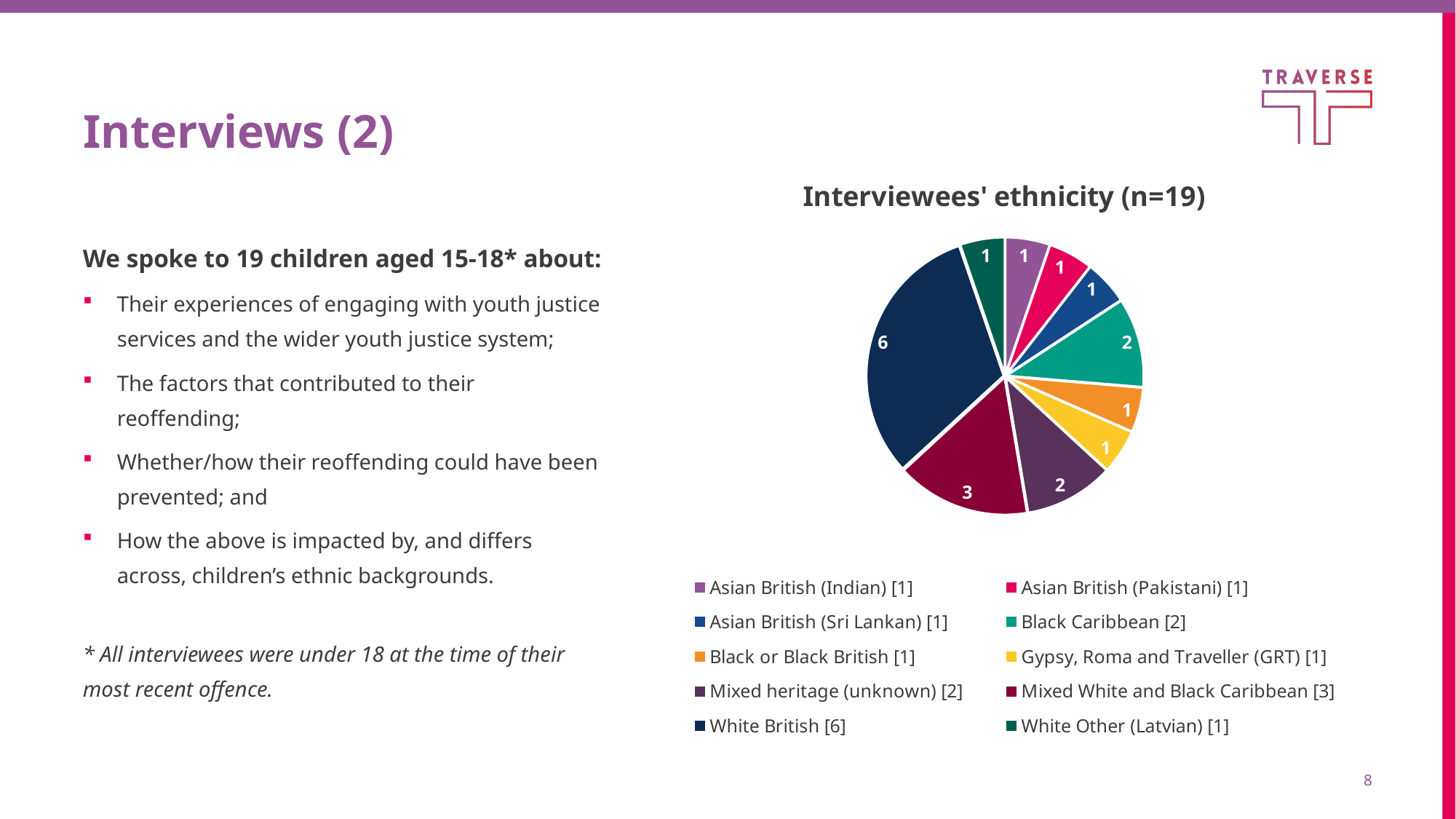
Which ethnicity category has the largest slice of the pie? White British How many categories in the chart have a value of 1? 6 Which is larger: the number of Black Caribbean interviewees or the number of Black or Black British interviewees? Black Caribbean How many interviewees are Mixed heritage (unknown)? 2 What is the total number of interviewees represented in the pie chart? 19 How many interviewees are Mixed White and Black Caribbean? 3 How many interviewees are White British? 6 What type of chart is shown on the slide? pie chart What is the difference between the number of White British interviewees and the number of Mixed White and Black Caribbean interviewees? 3 What is the title of the chart? Interviewees' ethnicity (n=19) How many categories does the legend list? 10 How many interviewees are Black Caribbean? 2